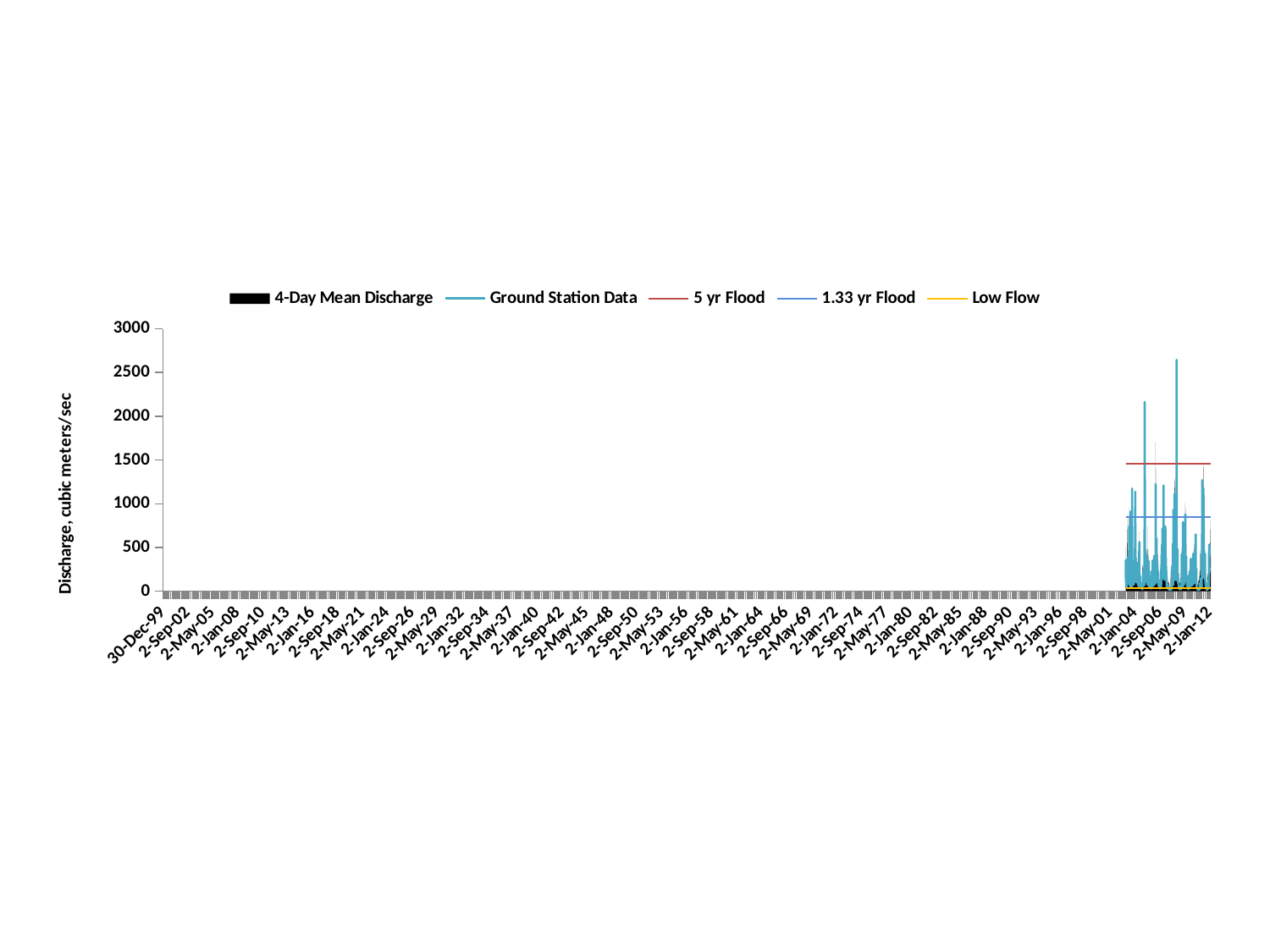
What is the highest value shown on the vertical axis? 3000 How many series does the legend list? 5 What colour is the 5 yr Flood line in the legend? red What is the label of the vertical axis? Discharge, cubic meters/sec What kind of chart is this? combination bar and line chart Is the 5 yr Flood line greater or less than 1000 cubic meters/sec? greater Is the Low Flow line greater or less than 500 cubic meters/sec? less Is the 1.33 yr Flood line greater or less than 1000 cubic meters/sec? less Which series reaches the highest value on the chart? Ground Station Data Which is higher on the chart, the 5 yr Flood line or the 1.33 yr Flood line? 5 yr Flood